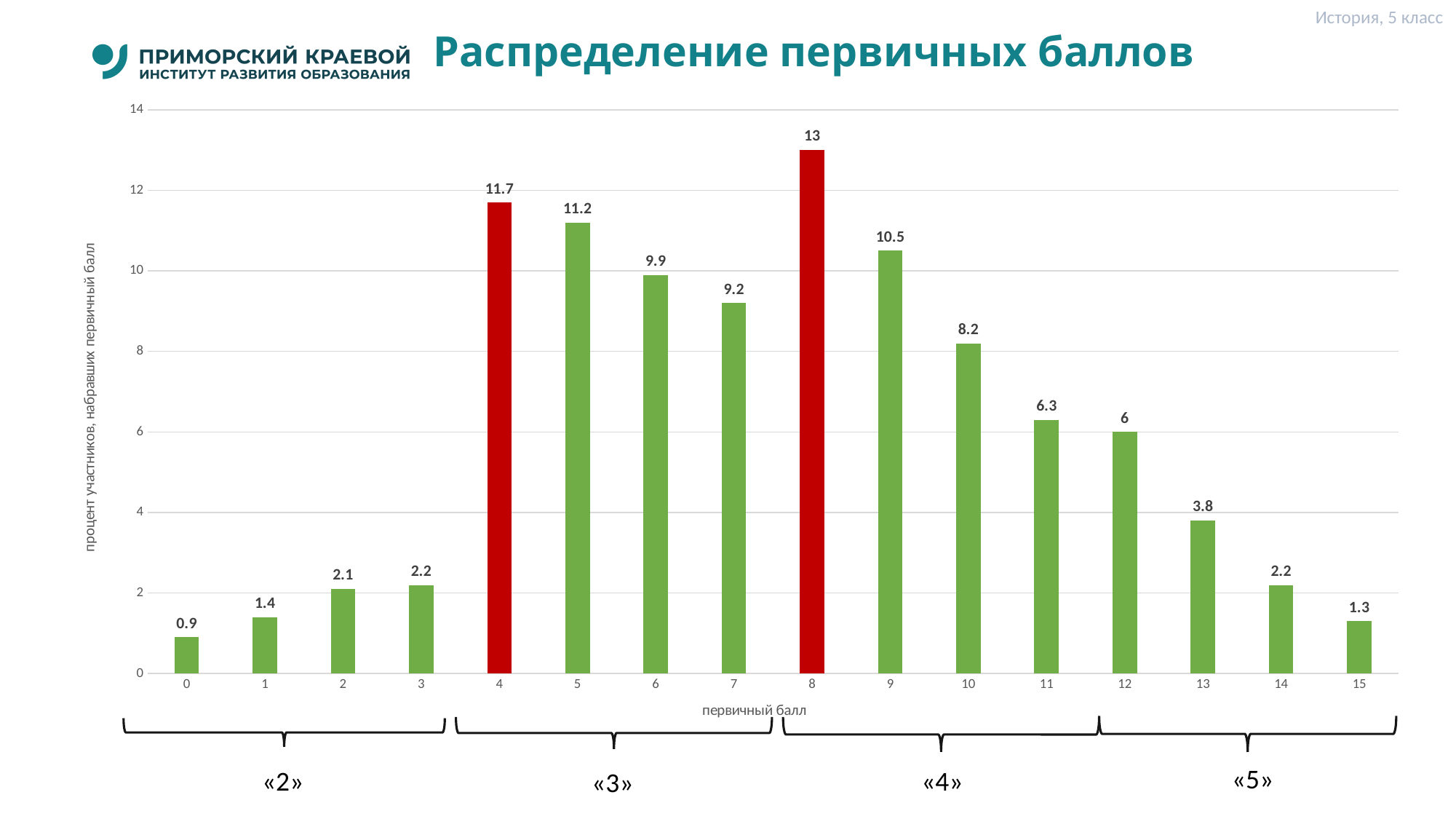
How many primary score categories are shown on the x axis? 16 Which is larger, the value for primary score 5 or primary score 9? primary score 5 What kind of chart is shown on the slide? bar chart What is the difference between the values for primary scores 8 and 4? 1.3 What is the value for primary score 8? 13 Which primary score has the highest percentage of participants? 8 Which primary score has the lowest percentage of participants? 0 What is the value for primary score 12? 6 Is the value for primary score 10 greater or less than 8? greater Do the values rise or fall from primary score 8 to primary score 15? fall What is the value for primary score 4? 11.7 Which two bars are coloured red? 4 and 8